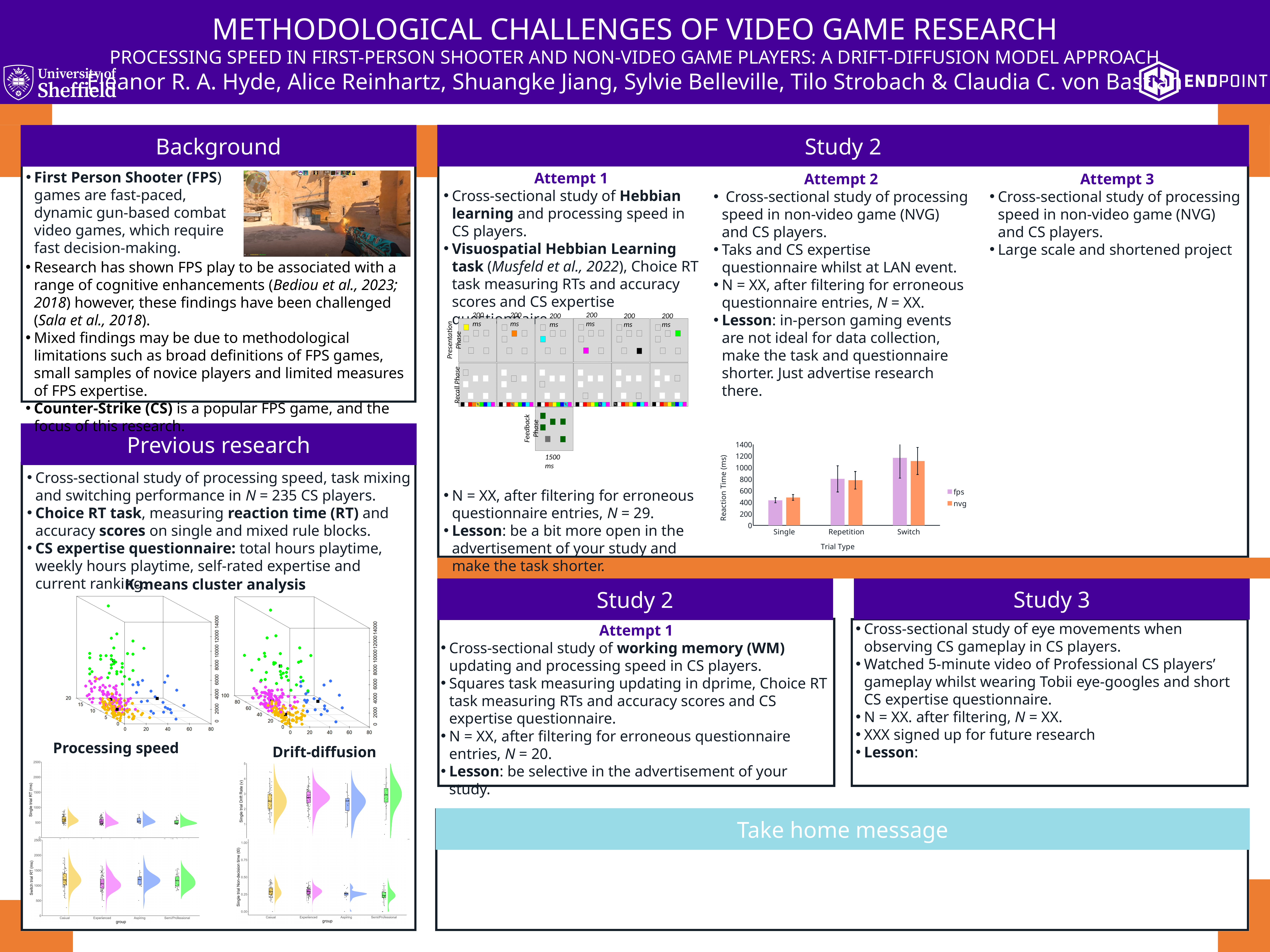
In the Reaction Time bar chart in the Study 2 section, which trial type has the highest reaction time for the fps series? Switch In the Reaction Time bar chart in the Study 2 section, which is larger for the fps series: Repetition or Switch? Switch In the Reaction Time bar chart in the Study 2 section, is the fps value for Single greater or less than 600? less In the Reaction Time bar chart in the Study 2 section, which trial type has the lowest reaction time for the nvg series? Single In the Reaction Time bar chart in the Study 2 section, what kind of chart is it? bar chart In the Reaction Time bar chart in the Study 2 section, how many series does the legend list? 2 In the Reaction Time bar chart in the Study 2 section, do reaction times rise or fall from Single to Switch? rise In the Reaction Time bar chart in the Study 2 section, is the nvg value for Repetition greater or less than 600? greater In the Reaction Time bar chart in the Study 2 section, is the fps value for Switch greater or less than 1000? greater In the Reaction Time bar chart in the Study 2 section, what are the two legend entries? fps and nvg In the Reaction Time bar chart in the Study 2 section, how many trial types are shown on the x axis? 3